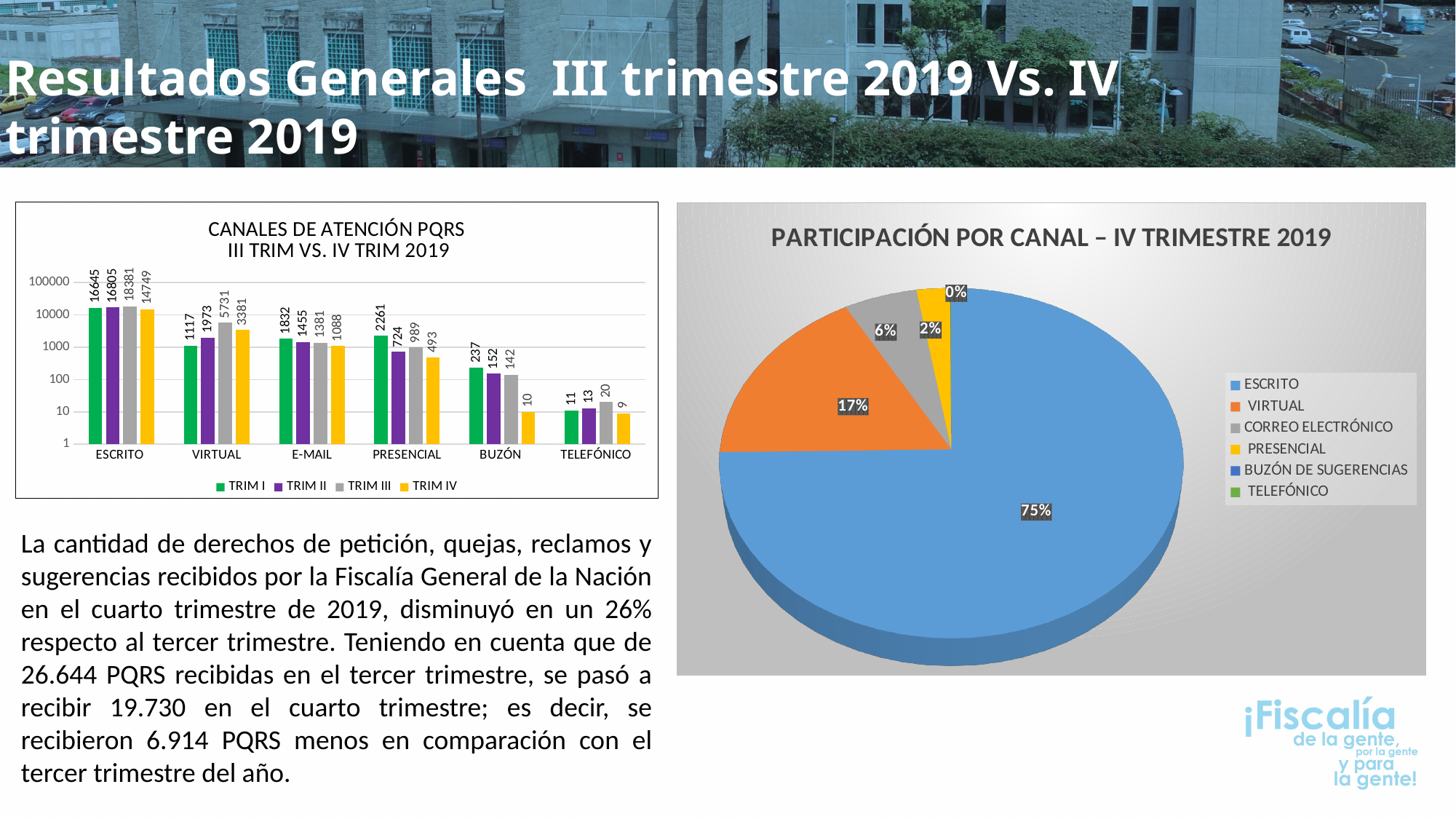
In the chart 'CANALES DE ATENCIÓN PQRS III TRIM VS. IV TRIM 2019', what is the TRIM III value for VIRTUAL? 5731 In the chart 'CANALES DE ATENCIÓN PQRS III TRIM VS. IV TRIM 2019', what is the TRIM I value for PRESENCIAL? 2261 What kind of chart is 'PARTICIPACIÓN POR CANAL – IV TRIMESTRE 2019'? Pie chart In the chart 'CANALES DE ATENCIÓN PQRS III TRIM VS. IV TRIM 2019', what is the difference between the TRIM III and TRIM IV values for ESCRITO? 3632 In the chart 'CANALES DE ATENCIÓN PQRS III TRIM VS. IV TRIM 2019', which is larger for BUZÓN: the TRIM I value or the TRIM IV value? TRIM I In the chart 'CANALES DE ATENCIÓN PQRS III TRIM VS. IV TRIM 2019', which category has the lowest TRIM III value? TELEFÓNICO In the pie chart 'PARTICIPACIÓN POR CANAL – IV TRIMESTRE 2019', what share does VIRTUAL have? 17% In the chart 'CANALES DE ATENCIÓN PQRS III TRIM VS. IV TRIM 2019', what is the TRIM IV value for ESCRITO? 14749 How many series does the legend of the chart 'CANALES DE ATENCIÓN PQRS III TRIM VS. IV TRIM 2019' list? 4 In the chart 'CANALES DE ATENCIÓN PQRS III TRIM VS. IV TRIM 2019', which category has the highest TRIM IV value? ESCRITO In the pie chart 'PARTICIPACIÓN POR CANAL – IV TRIMESTRE 2019', which channel has the largest share? ESCRITO How many categories are shown on the x axis of the chart 'CANALES DE ATENCIÓN PQRS III TRIM VS. IV TRIM 2019'? 6